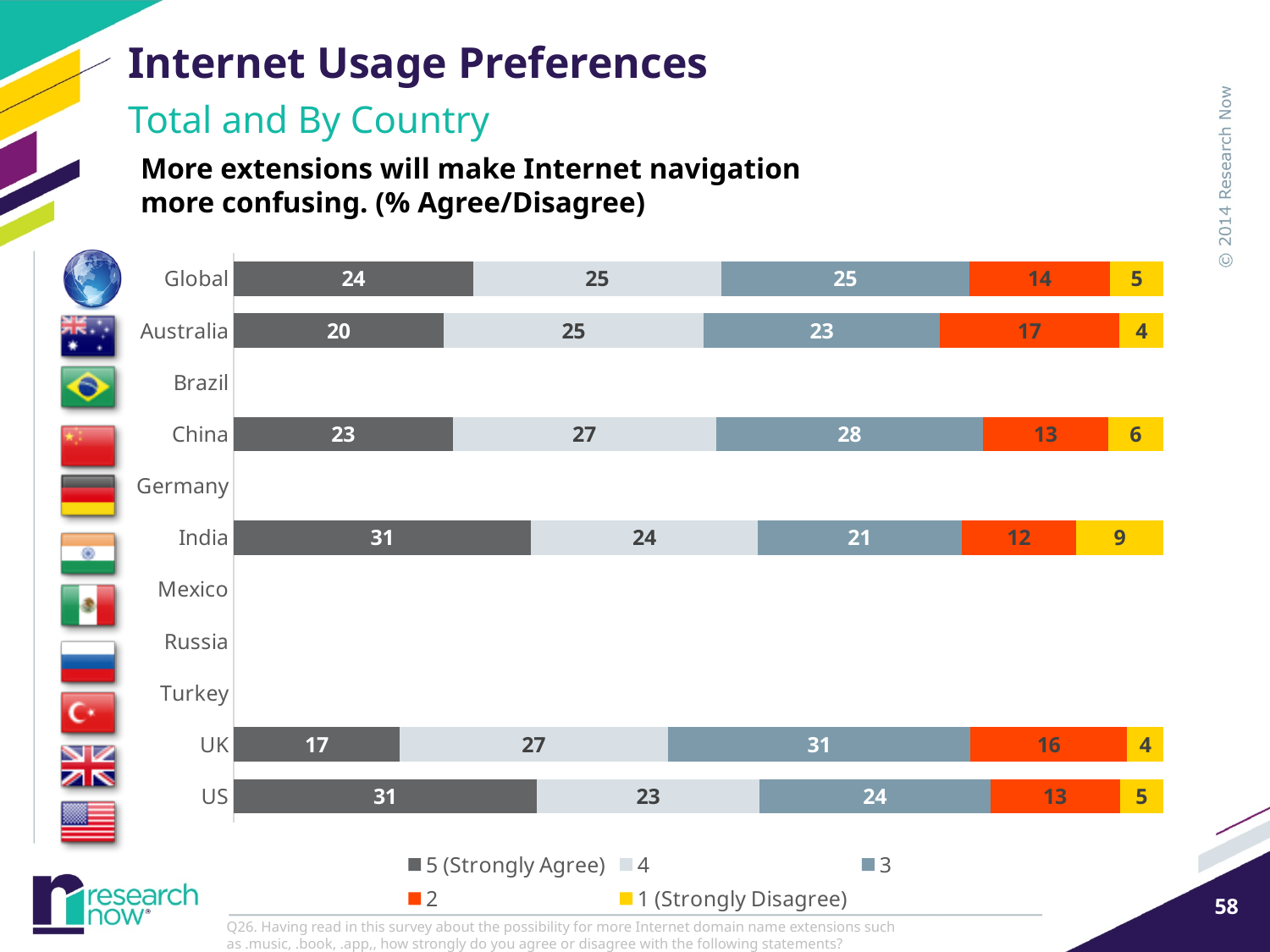
What is the total of the printed values in the Global bar? 93 Which country has the highest value in the 1 (Strongly Disagree) series? India What is the value for India in the 1 (Strongly Disagree) series? 9 How many countries or regions are listed on the vertical axis of the chart? 11 Which country has the lowest value in the 5 (Strongly Agree) series? UK What kind of chart is shown on the slide? Stacked bar chart Which has a larger 3 value, China or Australia? China What is the difference between the 5 (Strongly Agree) values for the US and the UK? 14 What is the value for the UK in the 3 series? 31 How many series does the legend list? 5 What percentage of Global respondents answered 5 (Strongly Agree)? 24 What is the value for Australia in the 2 series? 17